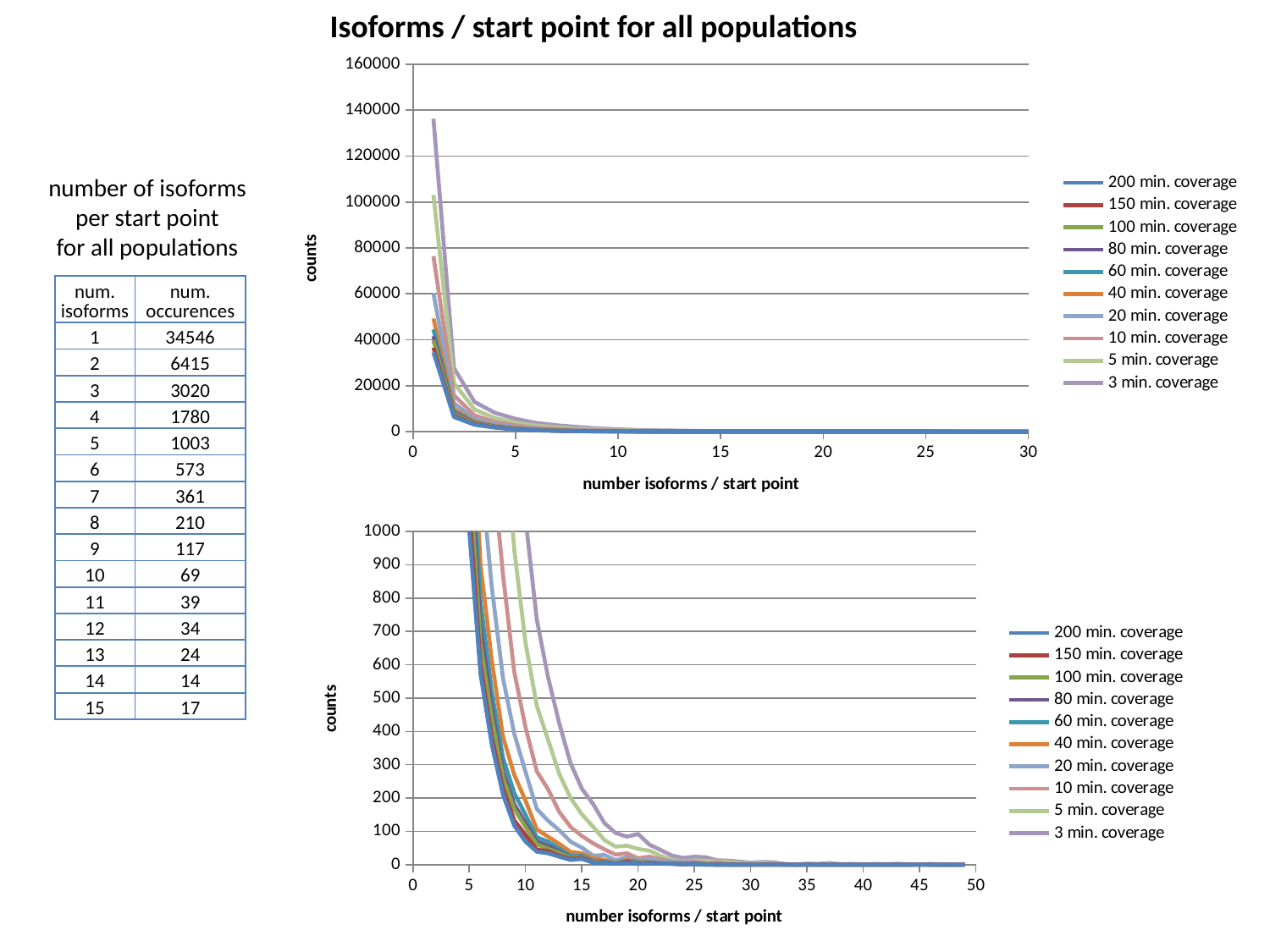
What kind of chart is the top chart titled 'Isoforms / start point for all populations'? line chart In the top chart, do the counts rise or fall as the number of isoforms per start point increases? fall In the top chart, is the value for 5 min. coverage at 1 isoform per start point greater or less than 80000? greater What is the label of the x axis on the top chart? number isoforms / start point What is the label of the y axis on the bottom chart? counts In the bottom chart, is the value for 3 min. coverage at 15 isoforms per start point greater or less than 200? greater In the top chart, which series has the highest count at 1 isoform per start point? 3 min. coverage How many series does the legend of the bottom chart list? 10 In the top chart, is the value for 3 min. coverage at 1 isoform per start point greater or less than 120000? greater How many series does the legend of the top chart list? 10 In the bottom chart, which series has the highest count at 20 isoforms per start point? 3 min. coverage